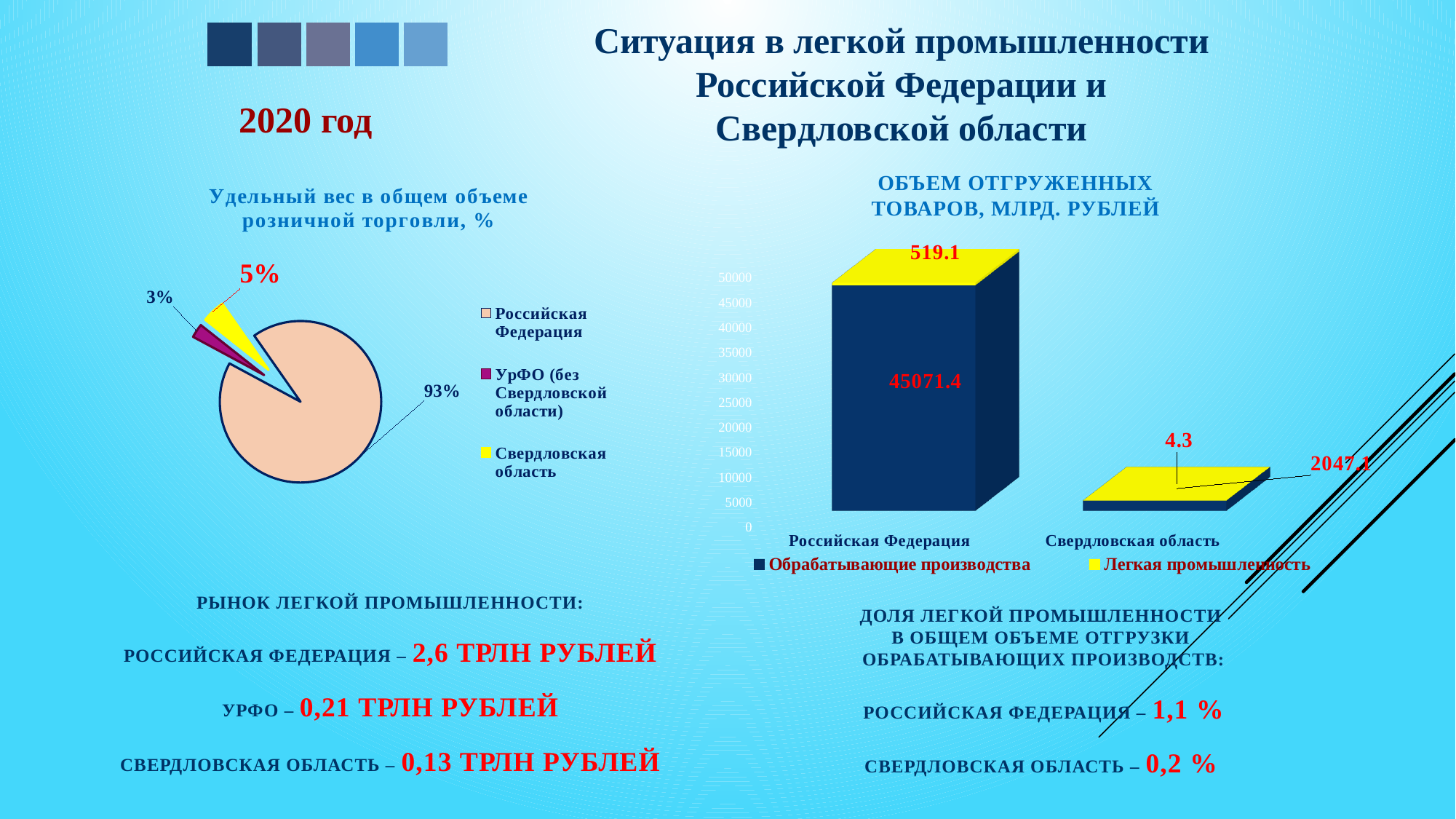
In the bar chart "Объем отгруженных товаров, млрд. рублей", what is the value of Обрабатывающие производства for Российская Федерация? 45071.4 In the bar chart "Объем отгруженных товаров, млрд. рублей", what is the value of Легкая промышленность for Свердловская область? 4.3 What type of chart is "Объем отгруженных товаров, млрд. рублей"? Stacked bar chart In the pie chart "Удельный вес в общем объеме розничной торговли, %", what share does УрФО (без Свердловской области) have? 3% In the bar chart "Объем отгруженных товаров, млрд. рублей", what is the difference between Легкая промышленность for Российская Федерация and for Свердловская область? 514.8 In the pie chart "Удельный вес в общем объеме розничной торговли, %", how many slices are there? 3 In the pie chart "Удельный вес в общем объеме розничной торговли, %", which category has the smallest slice? УрФО (без Свердловской области) In the bar chart "Объем отгруженных товаров, млрд. рублей", how many series does the legend list? 2 In the pie chart "Удельный вес в общем объеме розничной торговли, %", what share does Российская Федерация have? 93% In the bar chart "Объем отгруженных товаров, млрд. рублей", what is the total of the stacked bar for Российская Федерация? 45590.5 In the bar chart "Объем отгруженных товаров, млрд. рублей", what is the value of Обрабатывающие производства for Свердловская область? 2047.1 In the pie chart "Удельный вес в общем объеме розничной торговли, %", what share does Свердловская область have? 5%